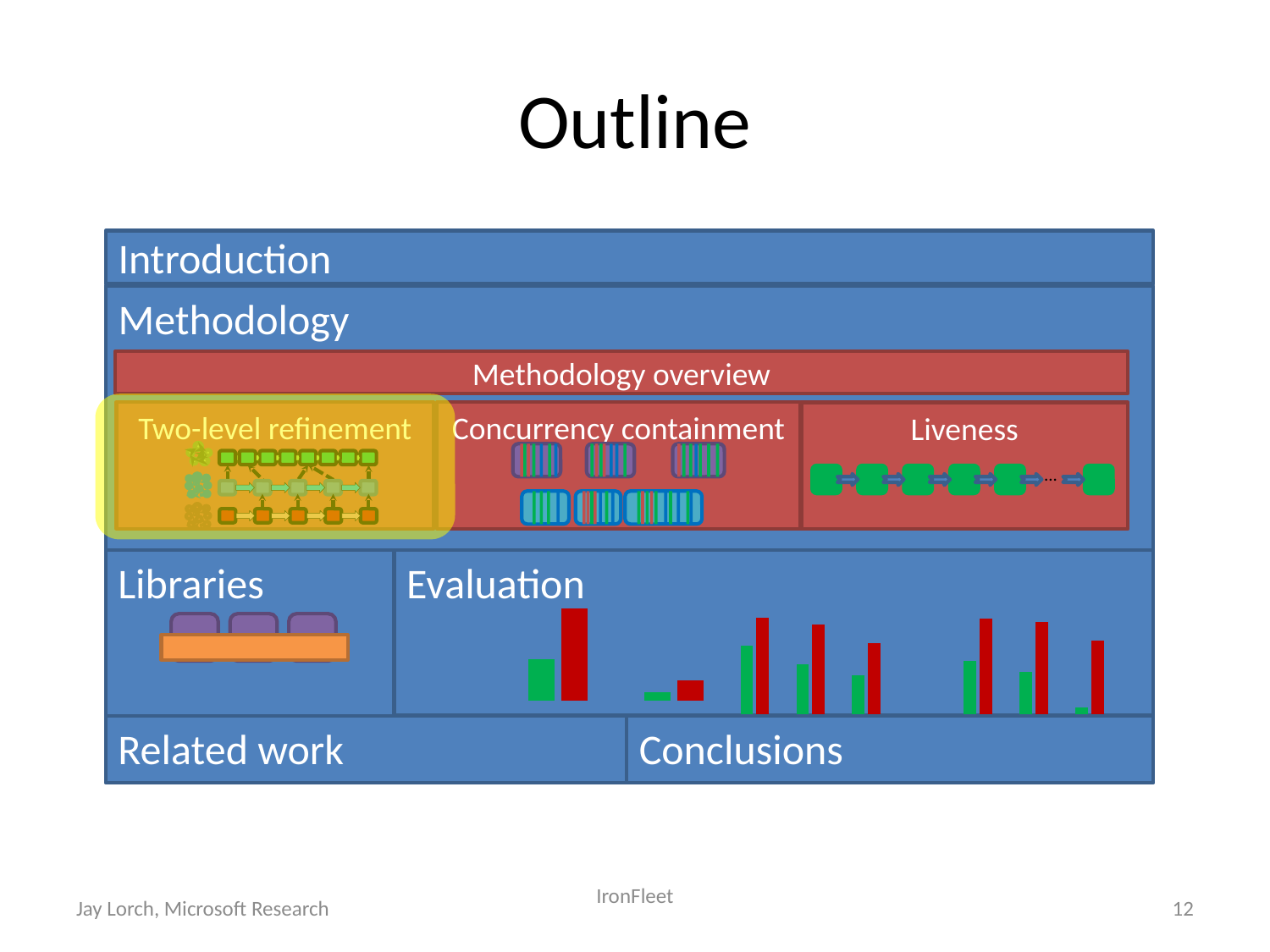
In the bar chart in the Evaluation section, are the red bars or the green bars taller? red What kind of chart is shown in the Evaluation section of the outline? bar chart In the bar chart in the Evaluation section, what two colours are the bars? green and red Does the bar chart in the Evaluation section show any axis labels or data values? No